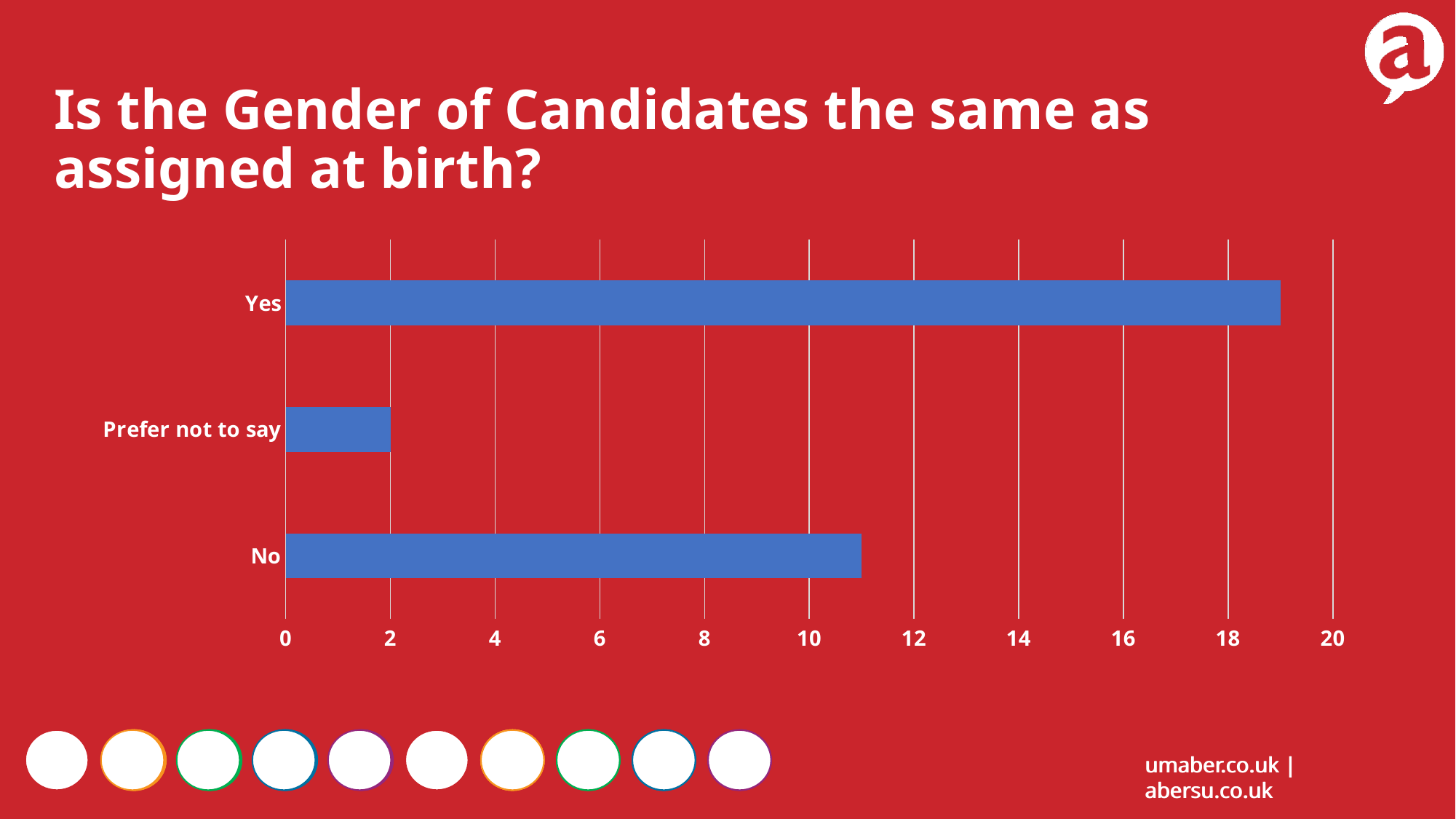
What is the title of the slide containing the chart? Is the Gender of Candidates the same as assigned at birth? How many categories are shown in the chart? 3 Which category has the highest value? Yes Is the value for "No" greater or less than 10? greater Which is larger, the value for "Yes" or the value for "No"? Yes Is the value for "Yes" greater or less than 18? greater Which is larger, the value for "No" or the value for "Prefer not to say"? No What is the value for "Prefer not to say"? 2 What is the maximum value shown on the horizontal axis? 20 Is the value for "No" greater or less than 12? less Which category has the lowest value? Prefer not to say What kind of chart is shown on the slide? bar chart